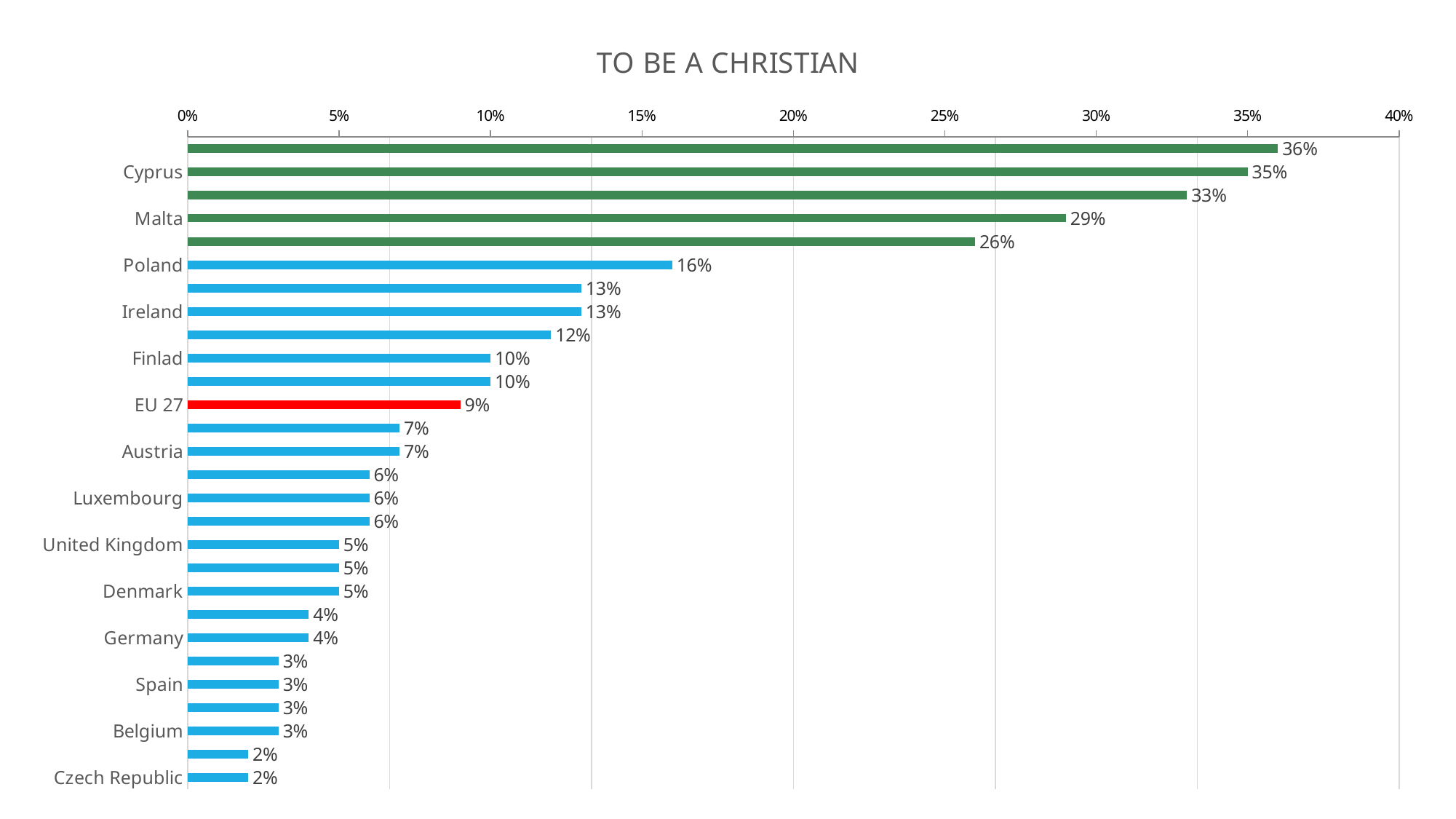
Is the value for Germany greater or less than 5%? less What is the value for EU 27? 9% Which has a larger value, Ireland or Finlad? Ireland What is the value for Poland? 16% What is the value for Malta? 29% What kind of chart is shown on the slide? bar chart What colour is the bar for EU 27? red What is the value for Czech Republic? 2% What is the value for Cyprus? 35% What is the largest value shown on the chart? 36% What is the difference between the values for Poland and EU 27? 7 percentage points What is the difference between the values for Cyprus and Malta? 6 percentage points